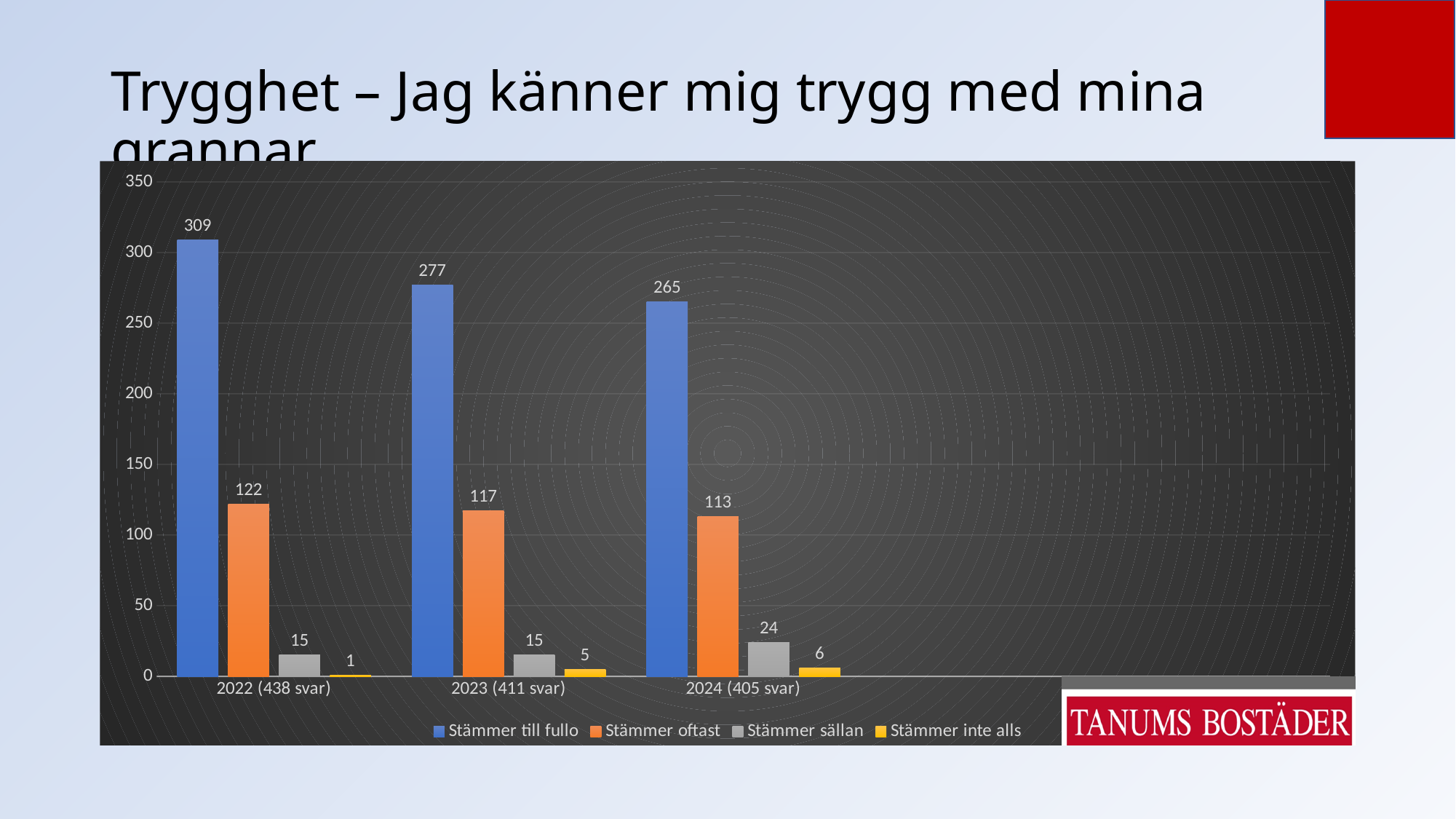
Which is larger: "Stämmer sällan" in 2024 (405 svar) or "Stämmer sällan" in 2023 (411 svar)? 2024 (405 svar) What is the value for "Stämmer sällan" in 2023 (411 svar)? 15 Which year has the lowest value for "Stämmer inte alls"? 2022 (438 svar) Does the value for "Stämmer till fullo" rise or fall from 2022 to 2024? Fall What is the value for "Stämmer till fullo" in 2022 (438 svar)? 309 What is the difference between the "Stämmer till fullo" values for 2022 (438 svar) and 2024 (405 svar)? 44 What is the value for "Stämmer inte alls" in 2022 (438 svar)? 1 What kind of chart is shown on the slide? Bar chart How many series does the legend list? 4 How many year categories are shown on the x axis? 3 Which year has the highest value for "Stämmer till fullo"? 2022 (438 svar) What is the value for "Stämmer oftast" in 2024 (405 svar)? 113